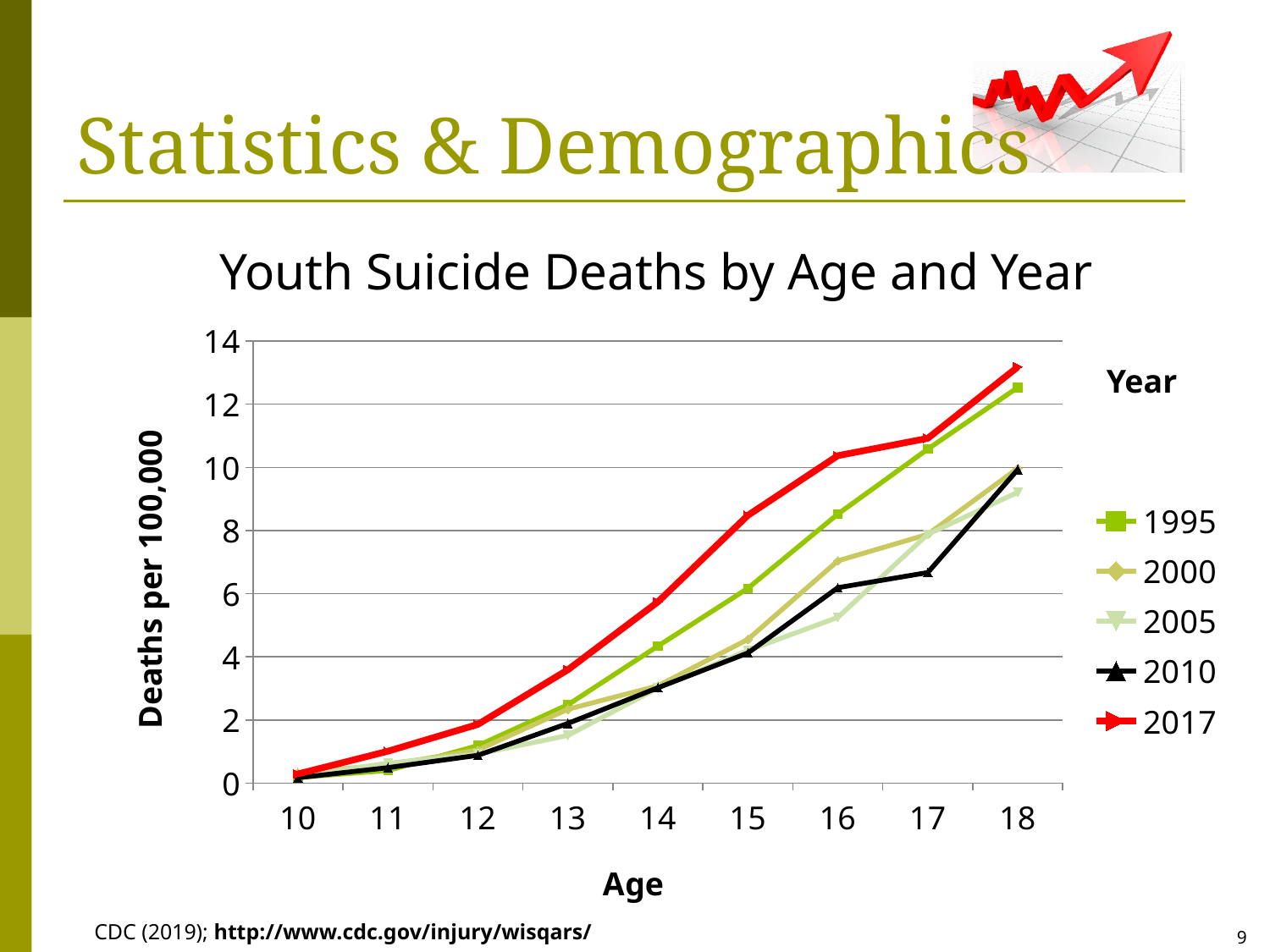
Is the value for 2010 at age 17 greater or less than 8? less How many years (series) does the legend list? 5 What is the label of the vertical axis? Deaths per 100,000 Which year has the lowest value at age 16? 2005 Is the value for 2017 at age 14 greater or less than 4? greater Do the values for the 2017 series rise or fall as age increases from 10 to 18? rise At age 16, which year has the larger value, 2017 or 2010? 2017 Which year has the highest value at age 18? 2017 At age 17, which year has the larger value, 1995 or 2000? 1995 What kind of chart is shown on the slide? line chart How many age categories are plotted along the x axis? 9 What is the title of the chart? Youth Suicide Deaths by Age and Year